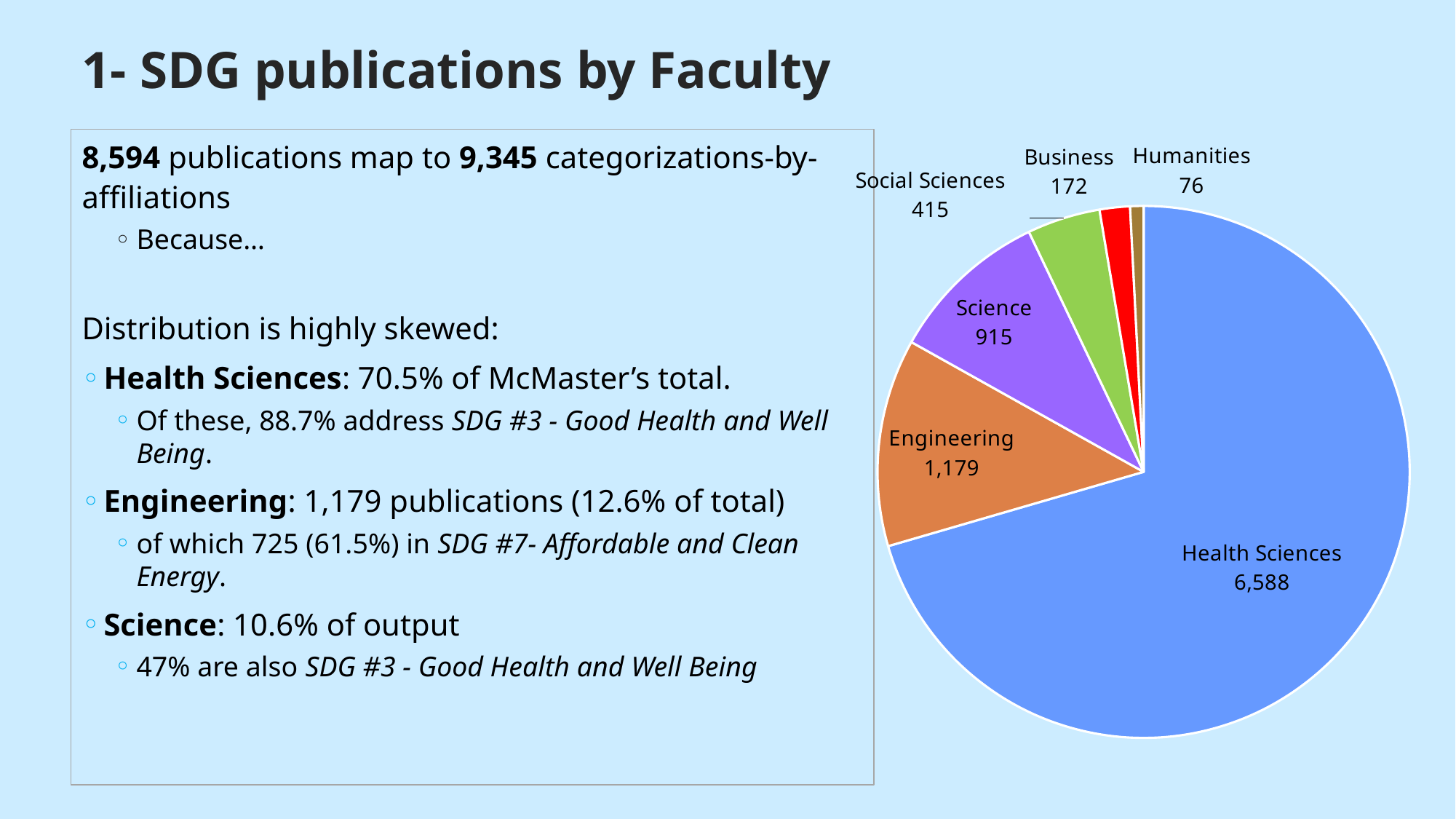
What share of the pie does Health Sciences represent? 70.5% Which is larger in the pie chart, Science or Social Sciences? Science What kind of chart is shown on the slide? pie chart What is the value for Social Sciences in the pie chart? 415 Which faculty has the smallest slice in the pie chart? Humanities What is the value for Engineering in the pie chart? 1,179 What is the value for Health Sciences in the pie chart? 6,588 What is the difference between the Business and Humanities values in the pie chart? 96 What is the value for Humanities in the pie chart? 76 What is the difference between the Engineering and Science values in the pie chart? 264 How many faculties (slices) does the pie chart show? 6 Which faculty has the largest slice in the pie chart? Health Sciences